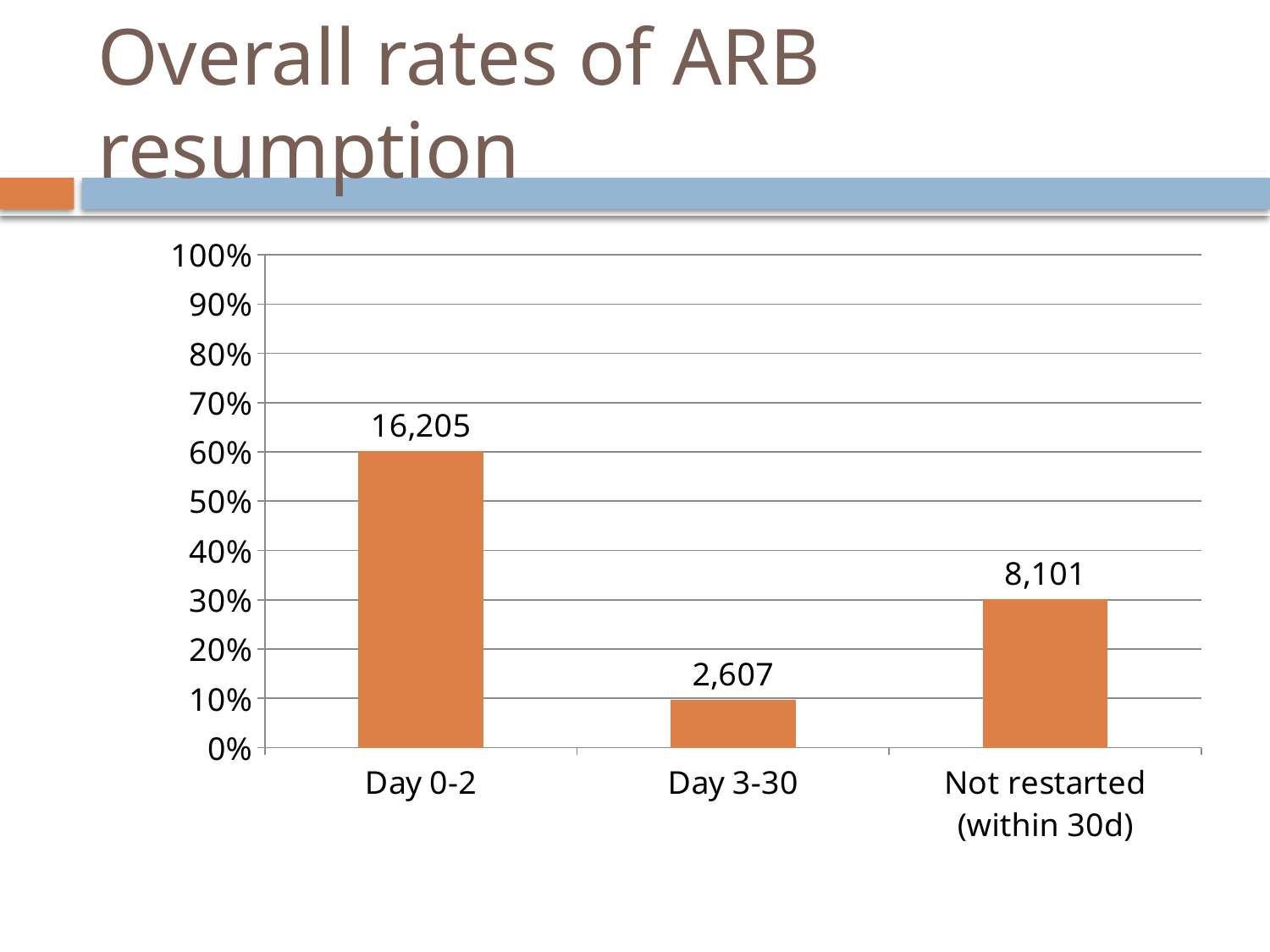
Which category has the highest bar? Day 0-2 How many categories are shown on the x axis? 3 What data label is shown on the Not restarted (within 30d) bar? 8,101 What type of chart is shown on the slide? Bar chart Is the value for Day 3-30 greater or less than 20%? less What data label is shown on the Day 0-2 bar? 16,205 What is the difference between the data labels for Day 0-2 and Day 3-30? 13,598 Which is larger, the bar for Not restarted (within 30d) or the bar for Day 3-30? Not restarted (within 30d) What data label is shown on the Day 3-30 bar? 2,607 What is the difference between the data labels for Not restarted (within 30d) and Day 3-30? 5,494 Is the value for Day 0-2 greater or less than 50%? greater Which category has the lowest bar? Day 3-30